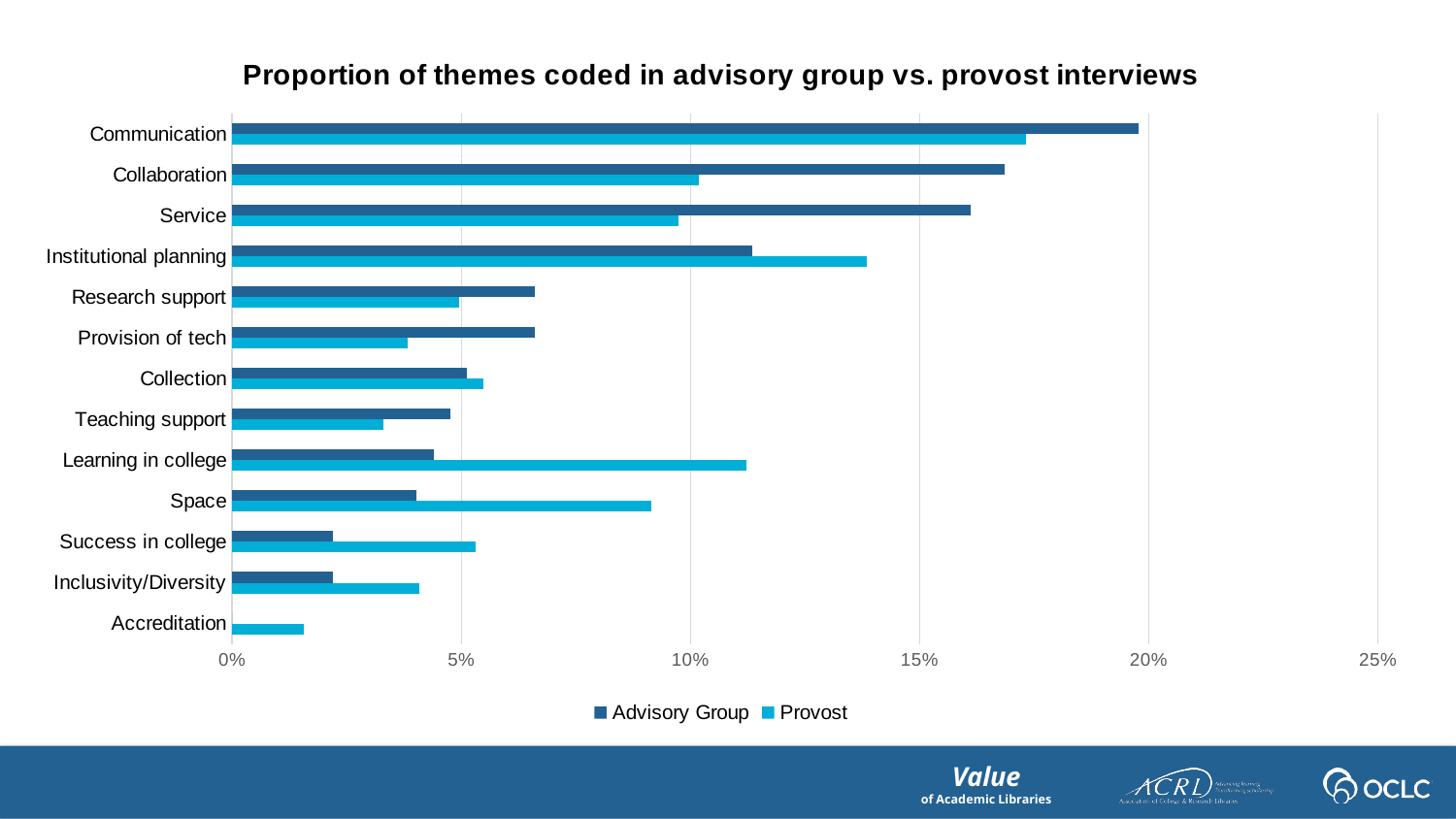
Which theme has the highest Provost value? Communication For Collaboration, which series has the larger value, Advisory Group or Provost? Advisory Group Is the Provost value for Institutional planning greater or less than 10%? greater What is the title of the chart? Proportion of themes coded in advisory group vs. provost interviews For Learning in college, which series has the larger value, Advisory Group or Provost? Provost How many series does the legend list? 2 How many theme categories are plotted on the chart? 13 Which theme has the highest Advisory Group value? Communication Which theme has the lowest Provost value? Accreditation Is the Provost value for Space greater or less than 10%? less What kind of chart is shown on the slide? bar chart Is the Advisory Group value for Communication greater or less than 15%? greater